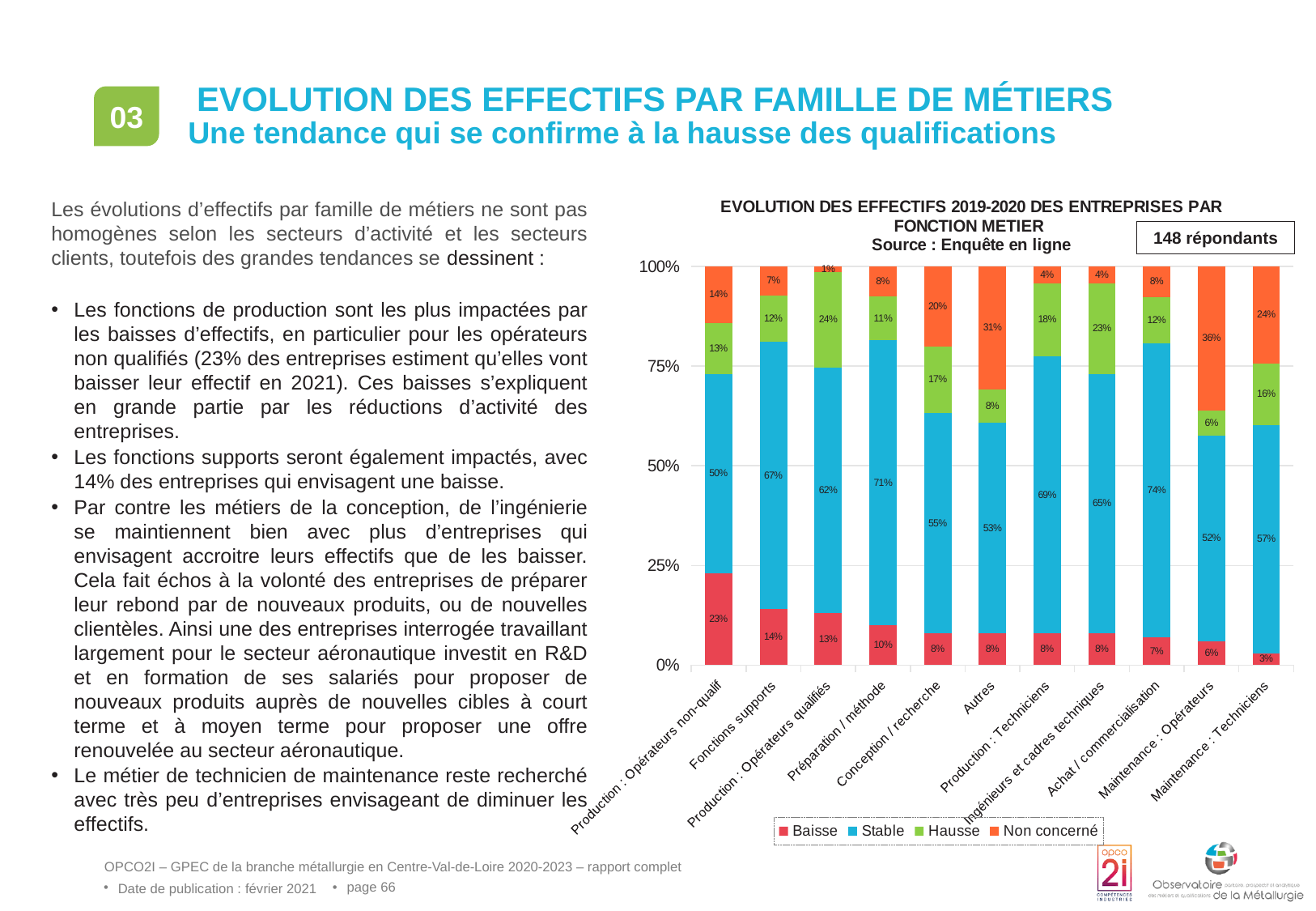
Which is larger: the 'Non concerné' value for 'Autres' or for 'Maintenance : Techniciens'? Autres What percentage of companies report a 'Baisse' for 'Production : Opérateurs non-qualif'? 23% How many series does the legend list? 4 How many job-family categories are shown on the x axis? 11 What is the difference between the 'Stable' value for 'Achat / commercialisation' and the 'Stable' value for 'Production : Opérateurs non-qualif'? 24 percentage points What is the 'Stable' value for 'Achat / commercialisation'? 74% What is the 'Non concerné' value for 'Maintenance : Opérateurs'? 36% Which category has the highest 'Stable' value? Achat / commercialisation Which category has the highest 'Baisse' value? Production : Opérateurs non-qualif What kind of chart is shown on the slide? Stacked bar chart What is the 'Hausse' value for 'Conception / recherche'? 17% Which category has the lowest 'Baisse' value? Maintenance : Techniciens